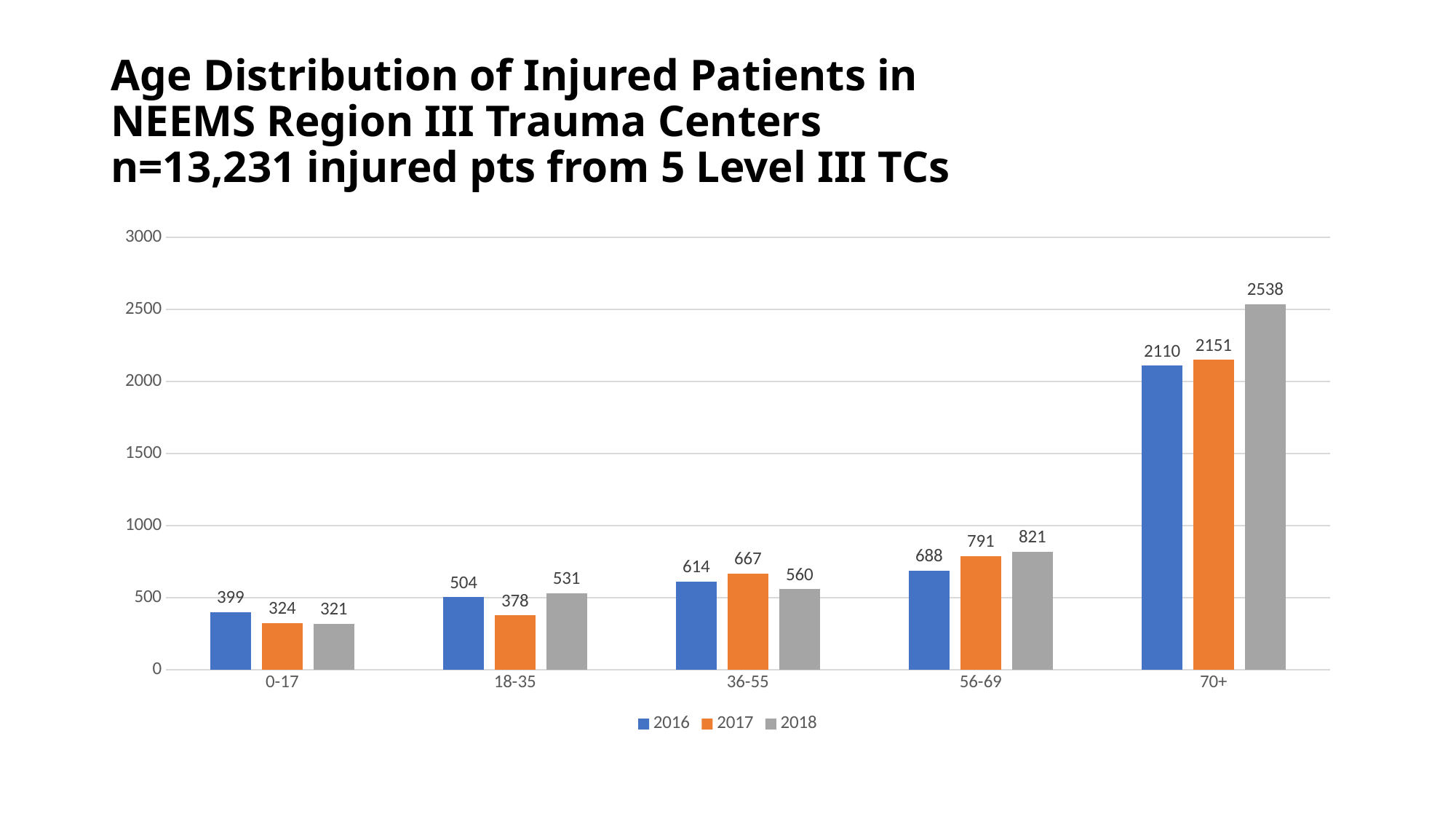
How many series does the legend list? 3 How many age groups are shown on the x axis? 5 Is the value for the 56-69 age group in 2018 greater or less than 1000? less What is the difference between the 2018 and 2016 values for the 70+ age group? 428 What is the value for the 0-17 age group in 2016? 399 Which is larger for the 36-55 age group: the 2017 value or the 2018 value? 2017 Which age group has the highest value in 2017? 70+ What is the value for the 70+ age group in 2018? 2538 Which age group has the lowest value in 2018? 0-17 Which colour represents the 2017 series in the legend? orange What kind of chart is shown on the slide? bar chart What is the value for the 18-35 age group in 2017? 378